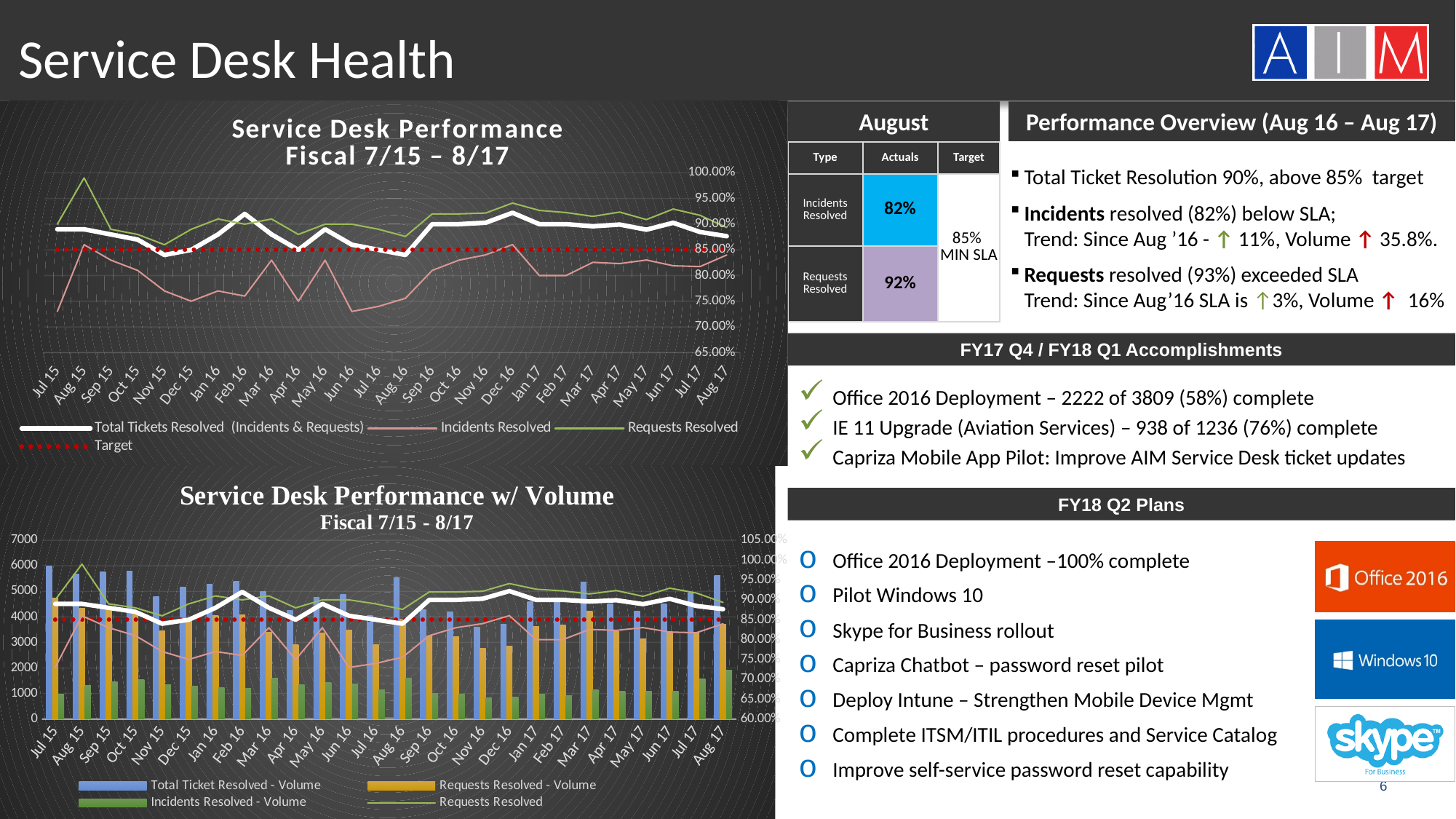
In the 'Service Desk Performance Fiscal 7/15 – 8/17' chart, is the Incidents Resolved value for Jul 15 greater or less than 80.00%? less In the 'Service Desk Performance w/ Volume' chart, which bar is taller for Aug 15: Requests Resolved - Volume or Incidents Resolved - Volume? Requests Resolved - Volume In the 'Service Desk Performance Fiscal 7/15 – 8/17' chart, which is higher in Aug 15: Incidents Resolved or Requests Resolved? Requests Resolved In the 'Service Desk Performance Fiscal 7/15 – 8/17' chart, does the Target line rise, fall, or stay flat across the months? stays flat What kind of chart is the 'Service Desk Performance w/ Volume' chart at the bottom left? combination bar and line chart What kind of chart is the 'Service Desk Performance Fiscal 7/15 – 8/17' chart at the top left? line chart In the 'Service Desk Performance Fiscal 7/15 – 8/17' chart, in which month does the Requests Resolved line reach its highest value? Aug 15 In the 'Service Desk Performance Fiscal 7/15 – 8/17' chart, is the Requests Resolved value for Aug 15 greater or less than 95.00%? greater In the 'Service Desk Performance w/ Volume' chart, is the Total Ticket Resolved - Volume bar for Jul 15 greater or less than 5000? greater How many series does the legend of the 'Service Desk Performance Fiscal 7/15 – 8/17' chart list? 4 How many series does the legend of the 'Service Desk Performance w/ Volume' chart list? 4 In the 'Service Desk Performance Fiscal 7/15 – 8/17' chart, how many months are plotted along the x axis? 26